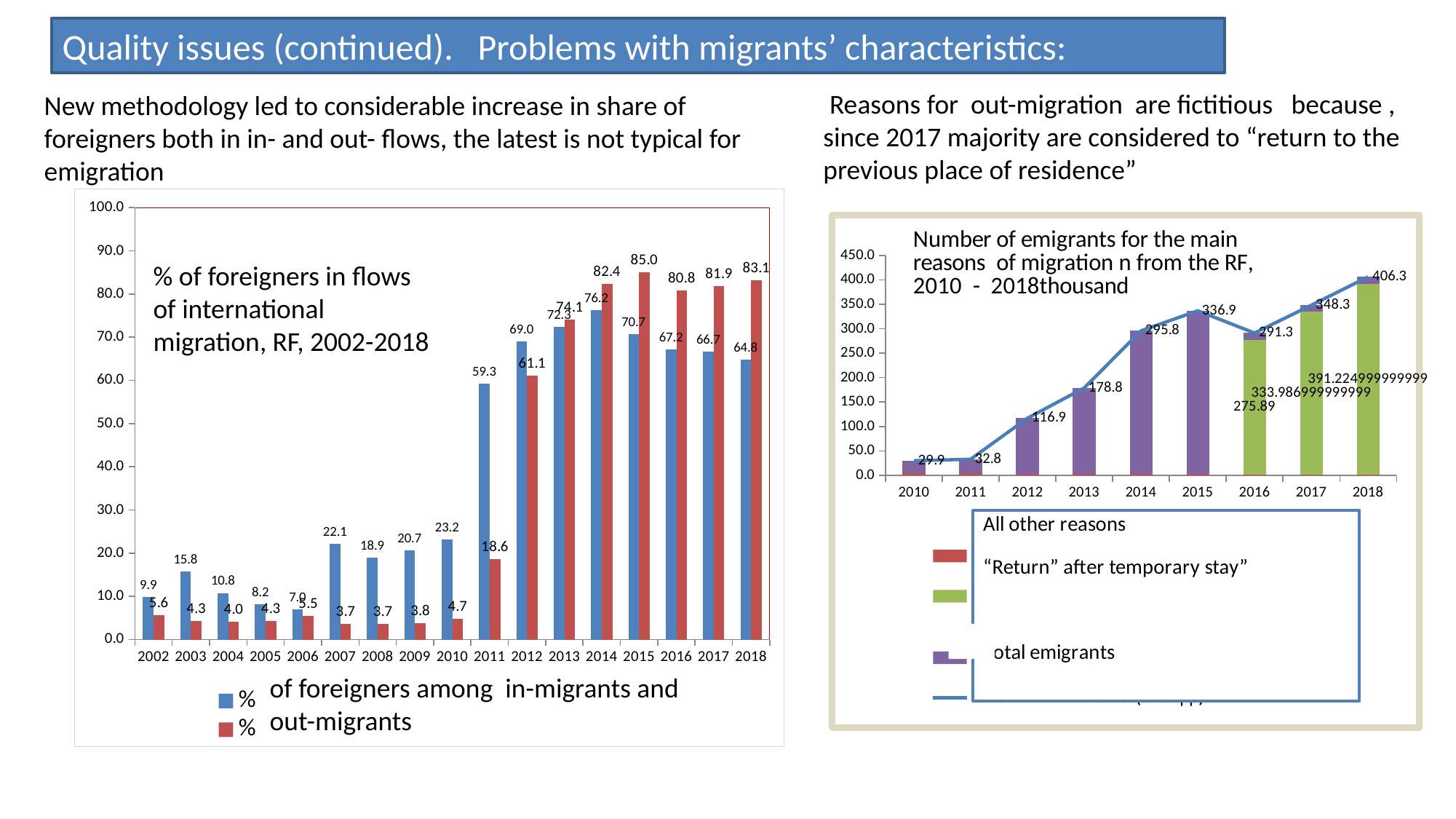
In the left chart (% of foreigners in flows of international migration), what is the difference between the out-migrant and in-migrant values in 2018? 18.3 How many years are shown on the x axis of the left chart (% of foreigners in flows of international migration)? 17 In the left chart (% of foreigners in flows of international migration), which is larger in 2012: the in-migrant (blue) value or the out-migrant (red) value? in-migrant (blue), 69.0 In the right chart (Number of emigrants for the main reasons of migration from the RF), what is the difference between the total emigrants values for 2018 and 2017? 58.0 How many series does the legend of the left chart (% of foreigners in flows of international migration) list? 2 In the left chart (% of foreigners in flows of international migration), what is the value for in-migrants (blue) in 2011? 59.3 In the right chart (Number of emigrants for the main reasons of migration from the RF), what is the total emigrants value for 2018? 406.3 What kind of chart is the left chart (% of foreigners in flows of international migration)? bar chart In the left chart (% of foreigners in flows of international migration), which year has the highest value for in-migrants (blue)? 2014 In the left chart (% of foreigners in flows of international migration), what is the value for out-migrants (red) in 2015? 85.0 In the right chart (Number of emigrants for the main reasons of migration from the RF), do the total emigrants values rise or fall from 2010 to 2015? rise In the right chart (Number of emigrants for the main reasons of migration from the RF), which year has the lowest total emigrants value? 2010